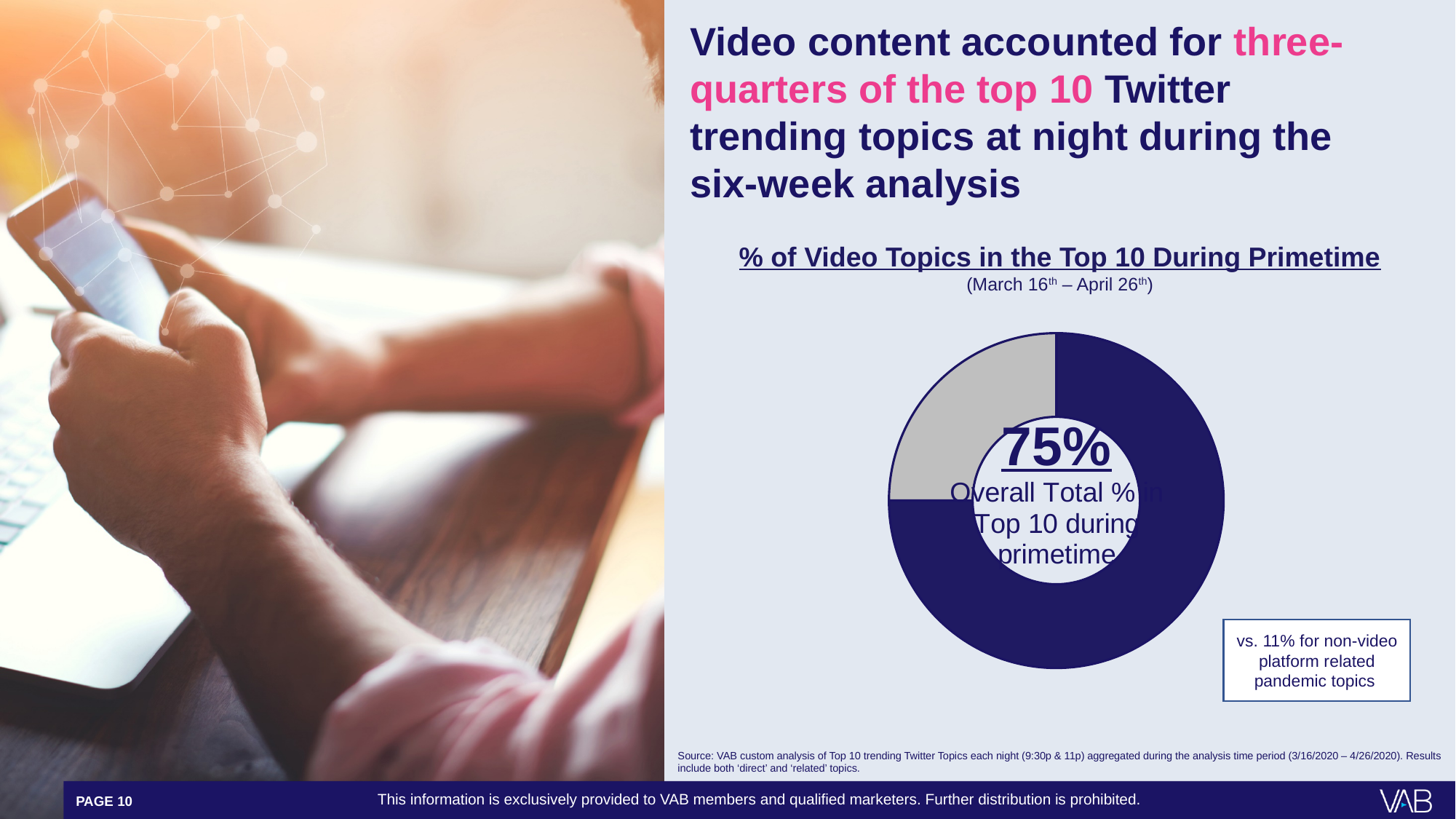
What share of the donut chart does the dark blue slice represent? 75% According to the chart, what is the overall total % of video topics in the Top 10 during primetime? 75% What date range is shown under the chart title? March 16th – April 26th Which is larger: the 75% for video topics or the 11% for non-video platform related pandemic topics? 75% for video topics What is the title of the chart? % of Video Topics in the Top 10 During Primetime What percentage is printed in the centre of the donut chart? 75% How many slices does the donut chart have? 2 What percentage is given in the box next to the chart for non-video platform related pandemic topics? 11% Which slice of the donut chart is larger, the dark blue one or the grey one? dark blue What kind of chart is shown on the slide? donut chart What is the difference between the 75% for video topics and the 11% for non-video platform related pandemic topics? 64 percentage points